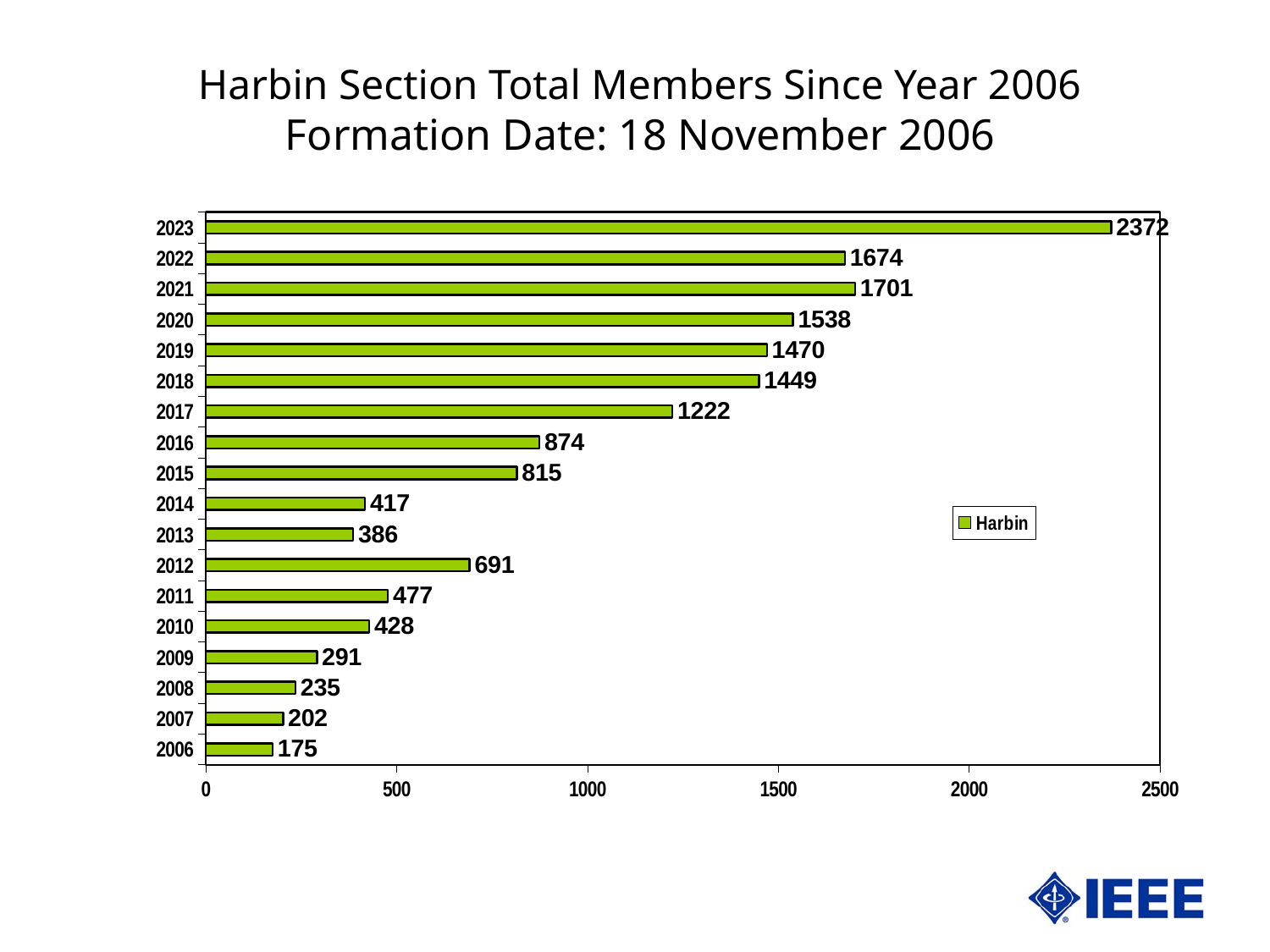
Which year has the lowest number of members? 2006 What is the total number of Harbin Section members in 2023? 2372 What is the difference between the values for 2012 and 2013? 305 What kind of chart is shown on the slide? bar chart What is the value for 2006? 175 Is the value for 2020 greater or less than 1500? greater Which year has the highest number of members? 2023 What is the difference between the values for 2023 and 2022? 698 How many years are shown in the chart? 18 Which is larger, the value for 2021 or the value for 2022? 2021 What series name does the legend show? Harbin What is the value for 2017? 1222